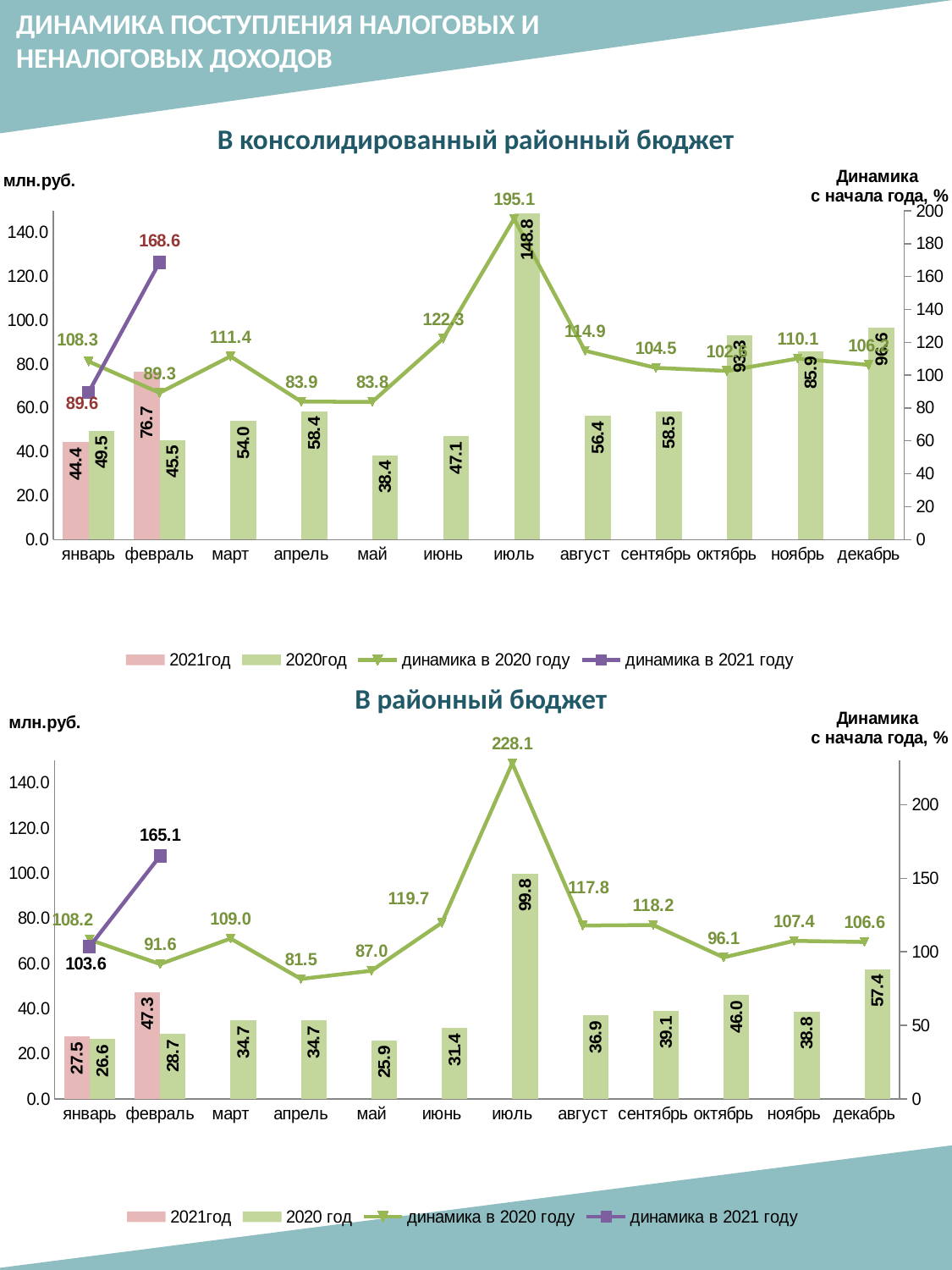
In the chart 'В районный бюджет', which month has the highest 2020 год bar? июль In the chart 'В консолидированный районный бюджет', what is the difference between the 2021 год and 2020 год bars for январь? 5.1 In the chart 'В консолидированный районный бюджет', how many series does the legend list? 4 In the chart 'В районный бюджет', how many months are shown on the x axis? 12 In the chart 'В районный бюджет', what is the value of 'динамика в 2020 году' for июль? 228.1 What type of chart is 'В районный бюджет'? Combined bar and line chart In the chart 'В консолидированный районный бюджет', what is the value of 'динамика в 2021 году' for февраль? 168.6 In the chart 'В консолидированный районный бюджет', which month has the lowest 2020 год bar? май In the chart 'В районный бюджет', what is the value of the 2020 год bar for декабрь? 57.4 In the chart 'В районный бюджет', which is larger for февраль: the 2021 год bar or the 2020 год bar? 2021 год In the chart 'В консолидированный районный бюджет', what is the value of the 2021 год bar for февраль? 76.7 In the chart 'В консолидированный районный бюджет', what is the value of the 2020 год bar for июль? 148.8